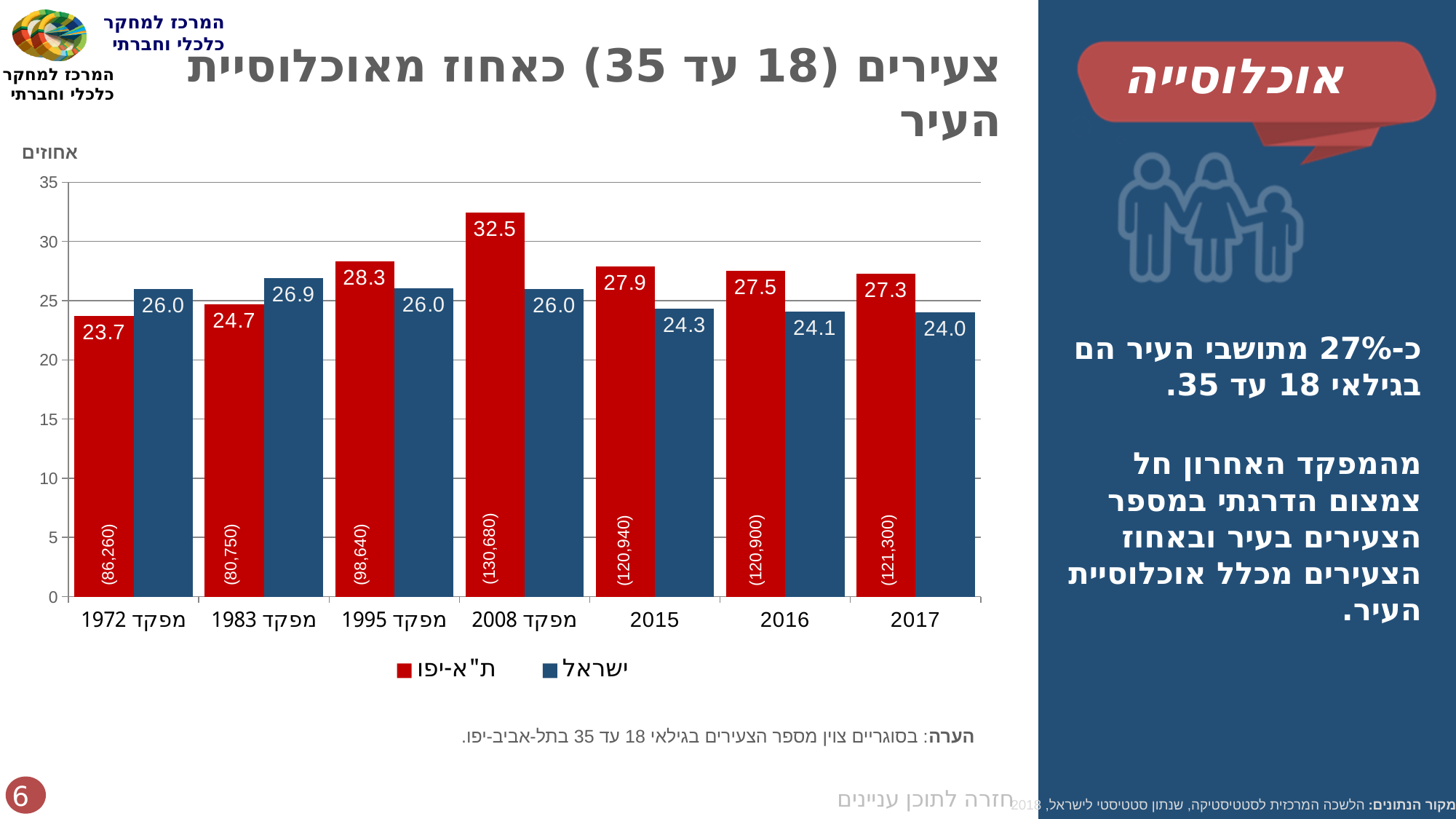
In which category is the ישראל value lowest? 2017 How many series does the legend list? 2 What kind of chart is shown on the slide? bar chart What is the value for ישראל in 2017? 24.0 Which is larger in מפקד 1983: ת"א-יפו or ישראל? ישראל How many categories are shown on the x axis? 7 What is the difference between the ת"א-יפו and ישראל values in מפקד 2008? 6.5 Is the value for ת"א-יפו in מפקד 2008 greater or less than 30? greater What is the value for ת"א-יפו in מפקד 1972? 23.7 What number is printed inside the ת"א-יפו bar for 2016? (120,900) What is the value for ת"א-יפו in מפקד 2008? 32.5 In which category is the ת"א-יפו value highest? מפקד 2008